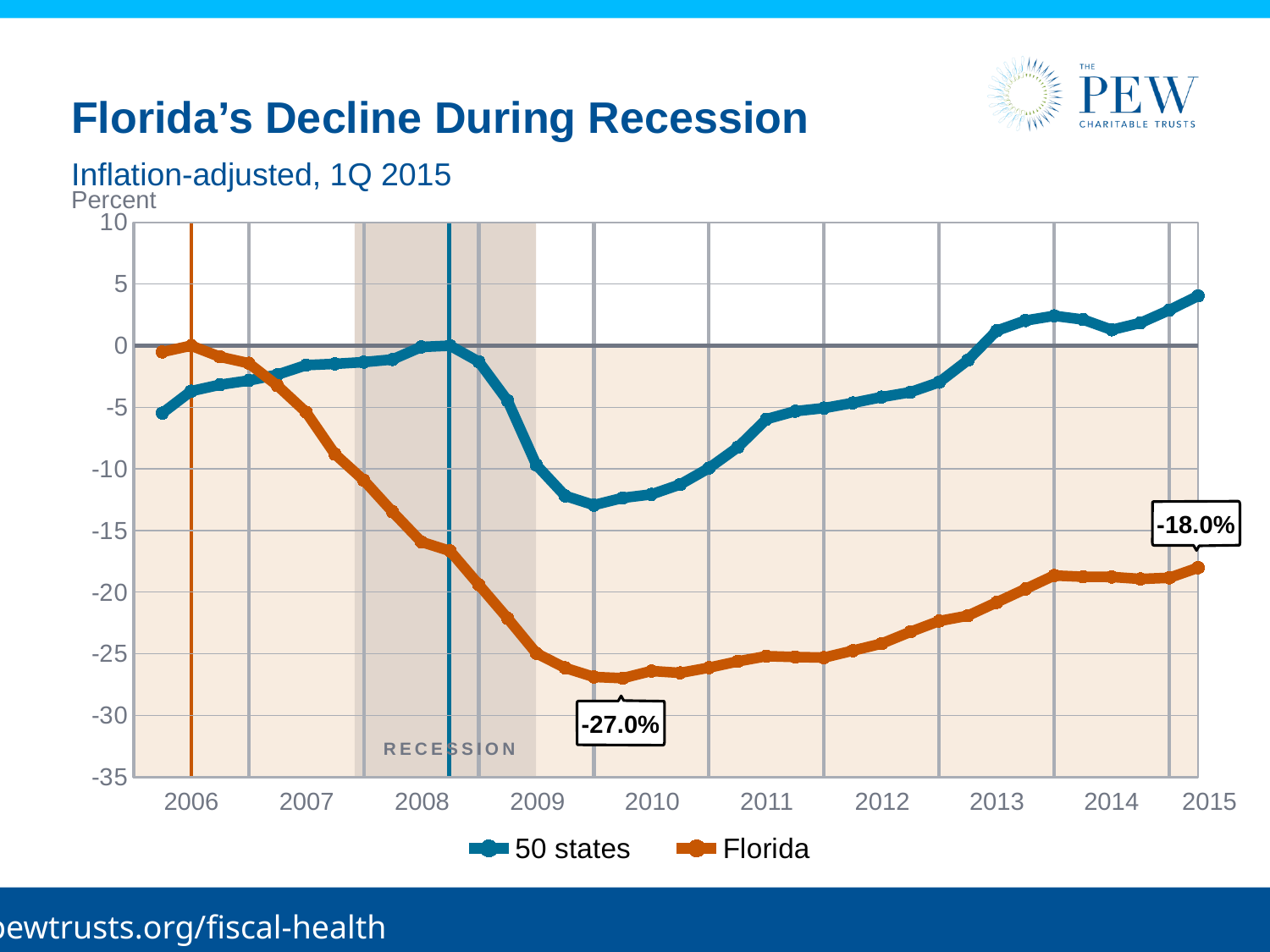
Which series reaches the lower minimum, 50 states or Florida? Florida Does the Florida line rise or fall between 2010 and 2015? Rise What is the difference between Florida's labeled 2015 value (-18.0%) and its labeled low point (-27.0%)? 9.0 percentage points Is the value for Florida at 2011 greater or less than -20? less What is the lowest labeled value for Florida? -27.0% What type of chart is shown on the slide? Line chart What is the title of the chart? Florida's Decline During Recession How many series does the legend list? 2 Is the value for 50 states at 2015 greater or less than 0? greater What is the labeled value for Florida at the end of the series in 2015? -18.0% Which series is higher in 2012, 50 states or Florida? 50 states What label appears in the shaded vertical band between 2007 and 2009? RECESSION